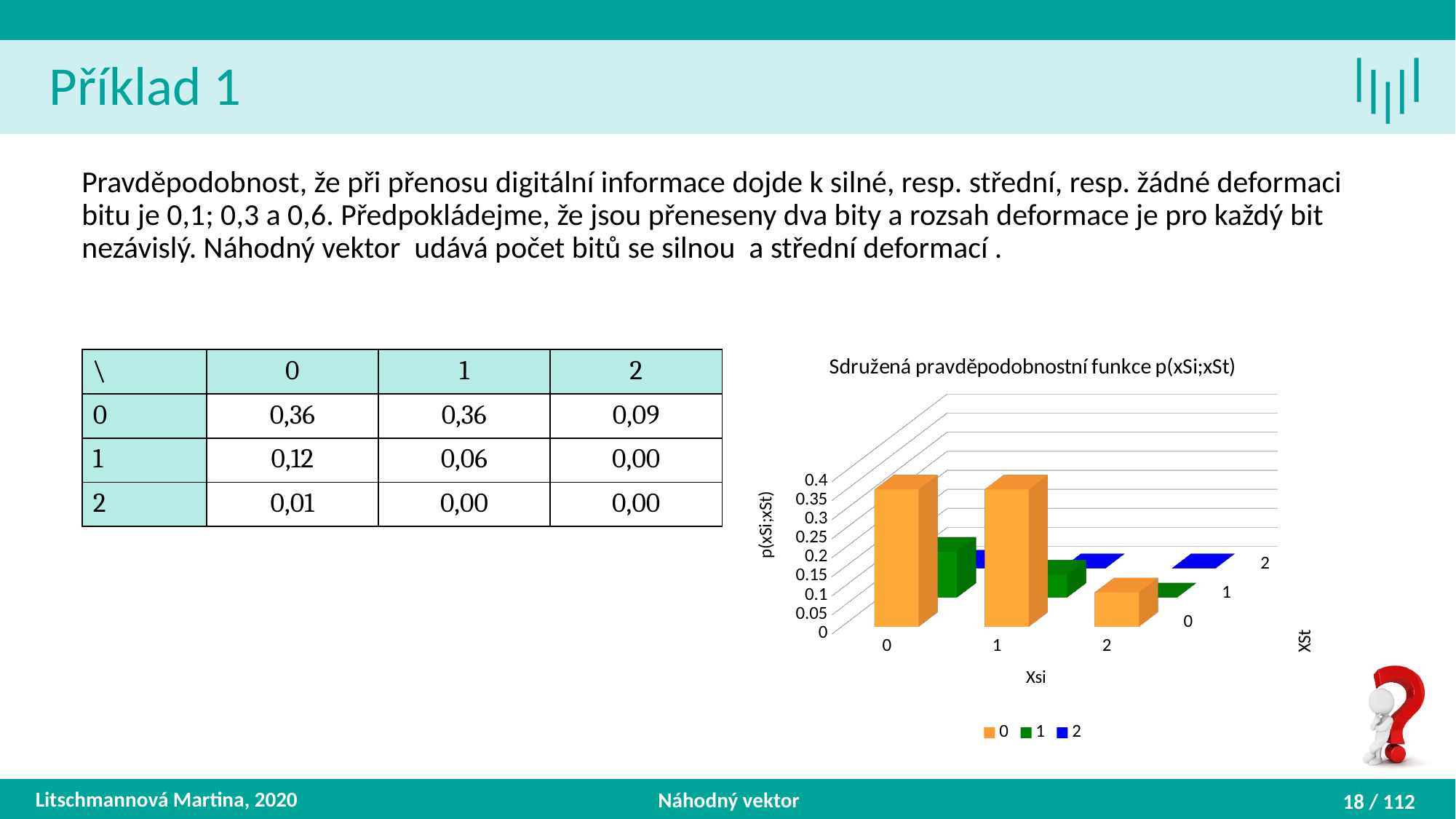
What is the label of the vertical axis of the chart? p(xSi;xSt) How many categories are shown on the Xsi axis of the chart? 3 Is the value of the green (XSt = 1) bar at Xsi = 0 greater or less than 0.3? less Which is larger: the orange (XSt = 0) bar at Xsi = 0 or the orange bar at Xsi = 2? Xsi = 0 What is the title of the chart? Sdružená pravděpodobnostní funkce p(xSi;xSt) How many series does the chart legend list? 3 Which series (XSt value) has the lowest bars across all Xsi categories? 2 Is the value of the orange (XSt = 0) bar at Xsi = 2 greater or less than 0.2? less Does the orange (XSt = 0) series rise or fall from Xsi = 1 to Xsi = 2? fall Which is larger: the green (XSt = 1) bar at Xsi = 0 or the green bar at Xsi = 1? Xsi = 0 What kind of chart is shown on the slide? bar chart Is the value of the orange (XSt = 0) bar at Xsi = 0 greater or less than 0.2? greater